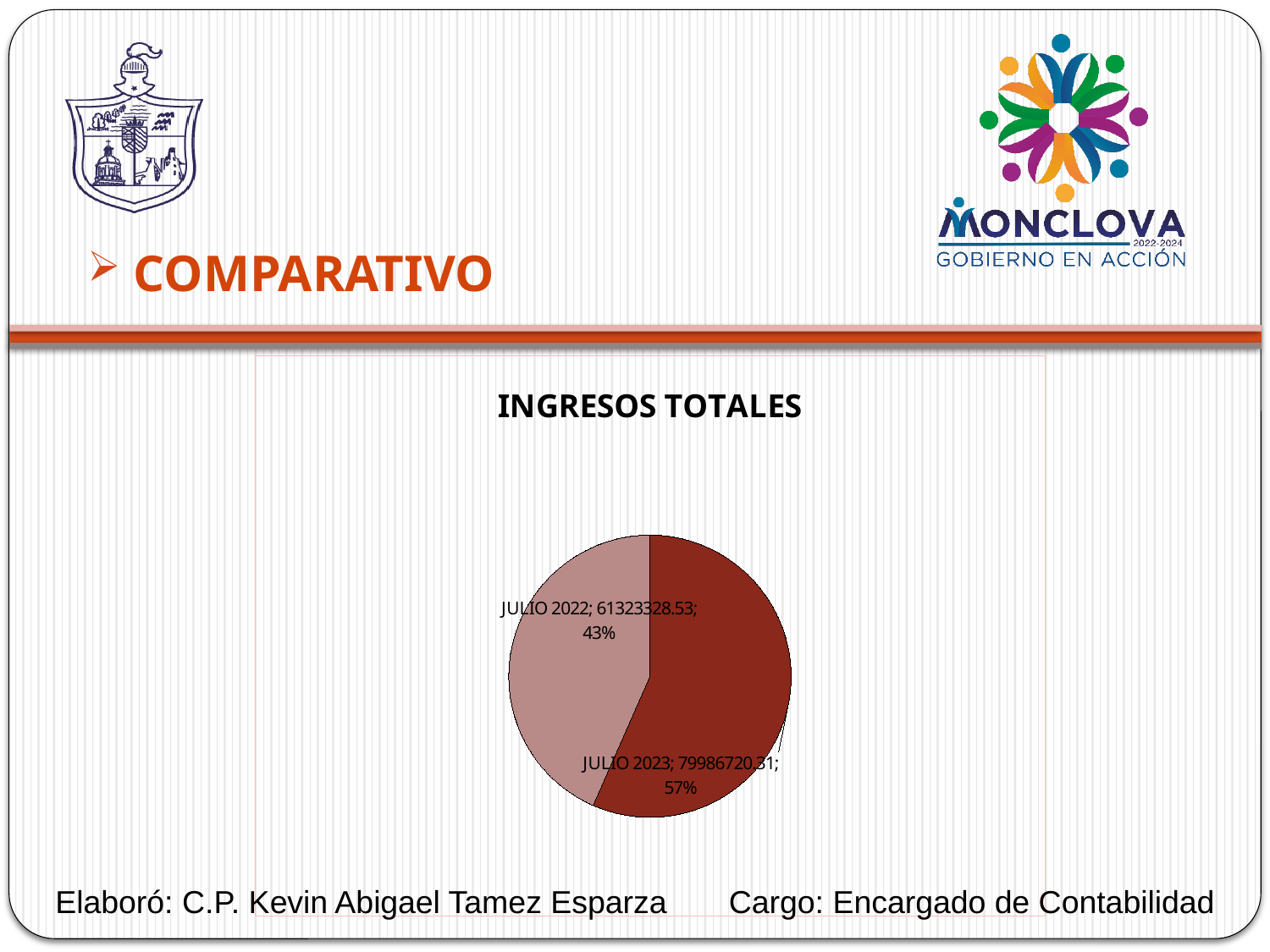
Which slice of the pie chart is drawn in the darker red colour? JULIO 2023 Which slice of the pie chart is the largest? JULIO 2023 How many slices does the INGRESOS TOTALES pie chart have? 2 What kind of chart is shown under the title INGRESOS TOTALES? Pie chart What is the value shown for JULIO 2023 in the pie chart? 79986720.31 What is the title of the chart on the slide? INGRESOS TOTALES What share of the pie does JULIO 2023 represent? 57% By how many percentage points does the JULIO 2023 share exceed the JULIO 2022 share? 14 percentage points What share of the pie does JULIO 2022 represent? 43% What is the value shown for JULIO 2022 in the pie chart? 61323328.53 Which is larger, the value for JULIO 2022 or JULIO 2023? JULIO 2023 Which slice of the pie chart is the smallest? JULIO 2022